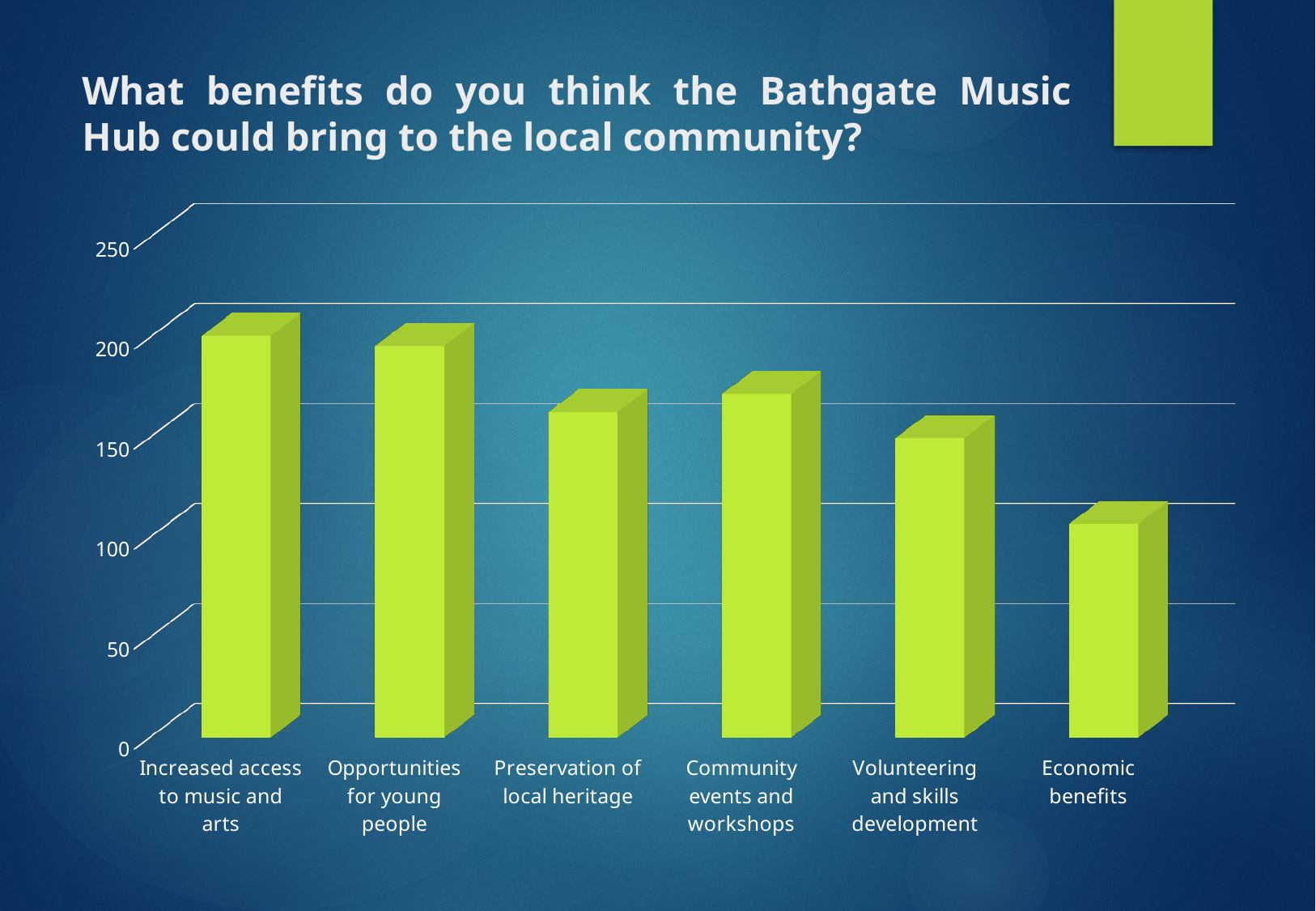
Is the value for Increased access to music and arts greater or less than 150? greater What colour are the bars in the chart? green Which category has the highest value in the chart? Increased access to music and arts Which is larger: the value for Opportunities for young people or the value for Volunteering and skills development? Opportunities for young people Which category has the lowest value in the chart? Economic benefits What kind of chart is shown on the slide? bar chart Which is larger: the value for Community events and workshops or the value for Preservation of local heritage? Community events and workshops Is the value for Preservation of local heritage greater or less than 200? less What is the title of the chart on the slide? What benefits do you think the Bathgate Music Hub could bring to the local community? Is the value for Economic benefits greater or less than 150? less How many categories are shown on the x axis of the chart? 6